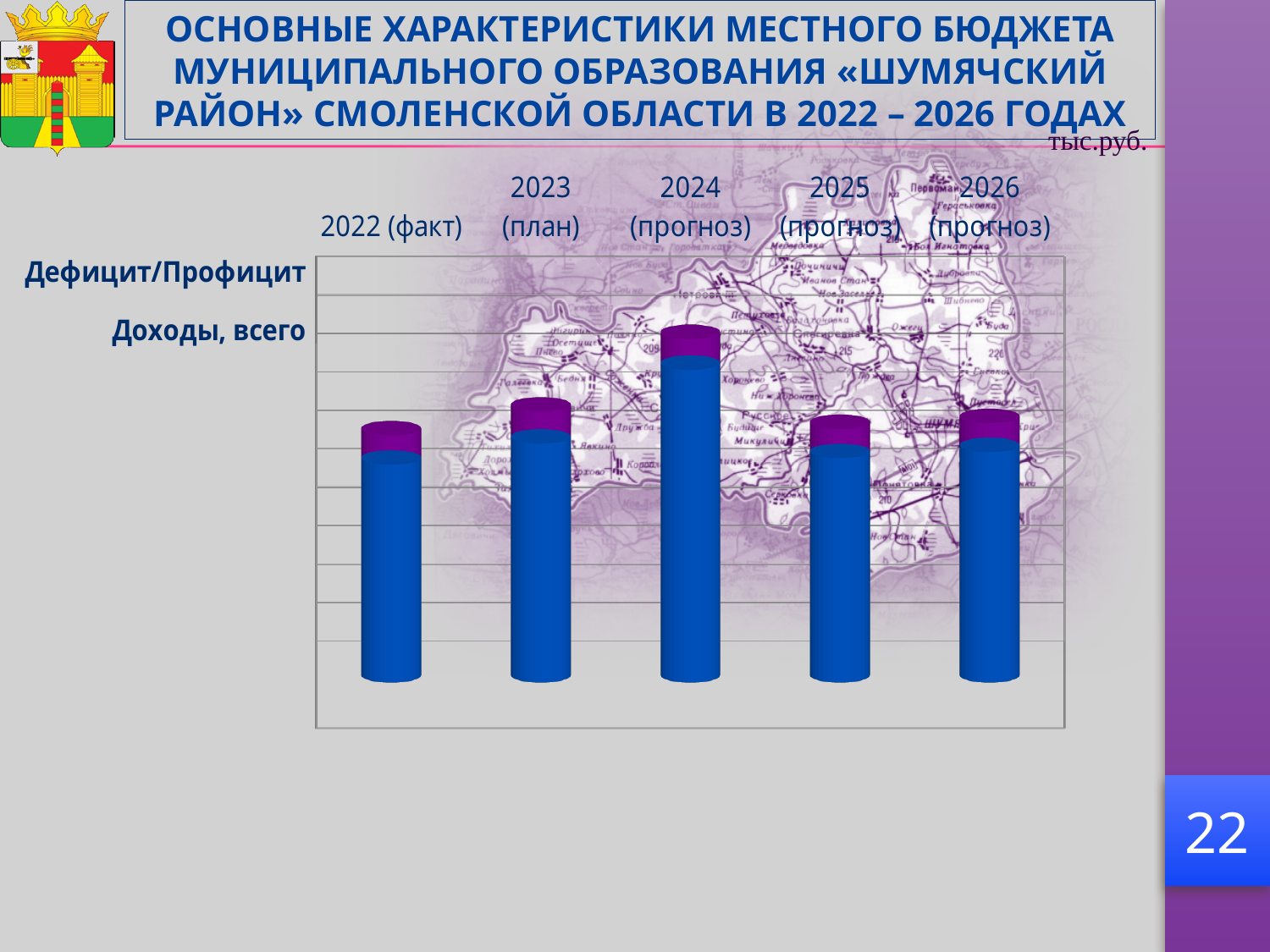
Which bar is taller, 2024 (прогноз) or 2022 (факт)? 2024 (прогноз) Which bar is taller, 2024 (прогноз) or 2025 (прогноз)? 2024 (прогноз) In what units are the chart values expressed, according to the label above the chart? тыс.руб. How many year categories are plotted along the x axis of the chart? 5 Which year has the tallest bar in the chart? 2024 (прогноз) Do the bars rise or fall from 2022 (факт) to 2024 (прогноз)? Rise Which bar is taller, 2023 (план) or 2022 (факт)? 2023 (план) What kind of chart is shown on the slide? Bar chart Do the bars rise or fall from 2024 (прогноз) to 2025 (прогноз)? Fall